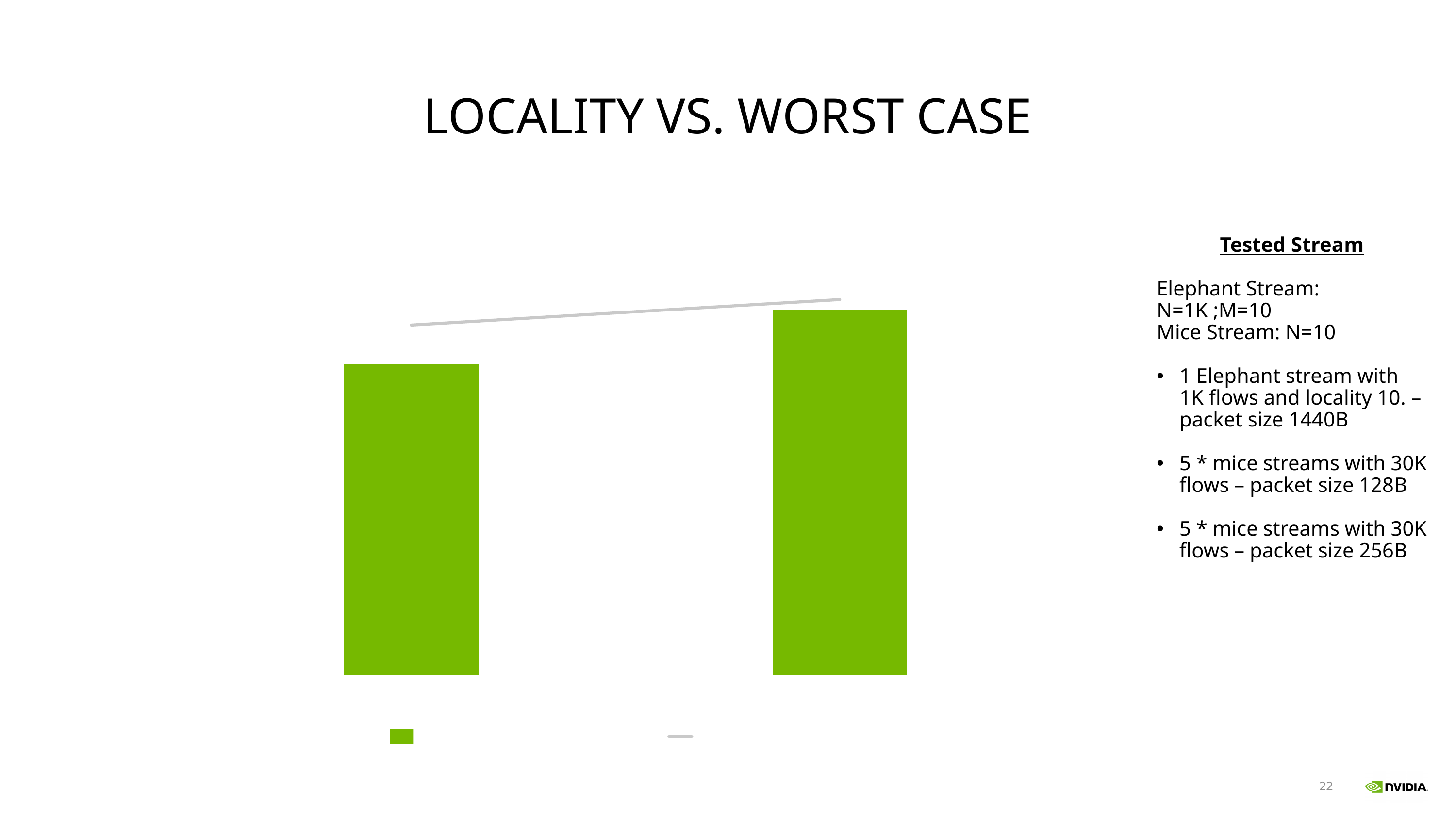
How many bars are plotted in the chart? 2 What kind of chart is shown on the slide? a combination bar and line chart How many entries does the chart's legend show? 2 What is the title of the slide containing the chart? LOCALITY VS. WORST CASE Which bar is taller, the left bar or the right bar? the right bar Does the grey line in the chart rise or fall from left to right? rise What colour are the bars in the chart? green